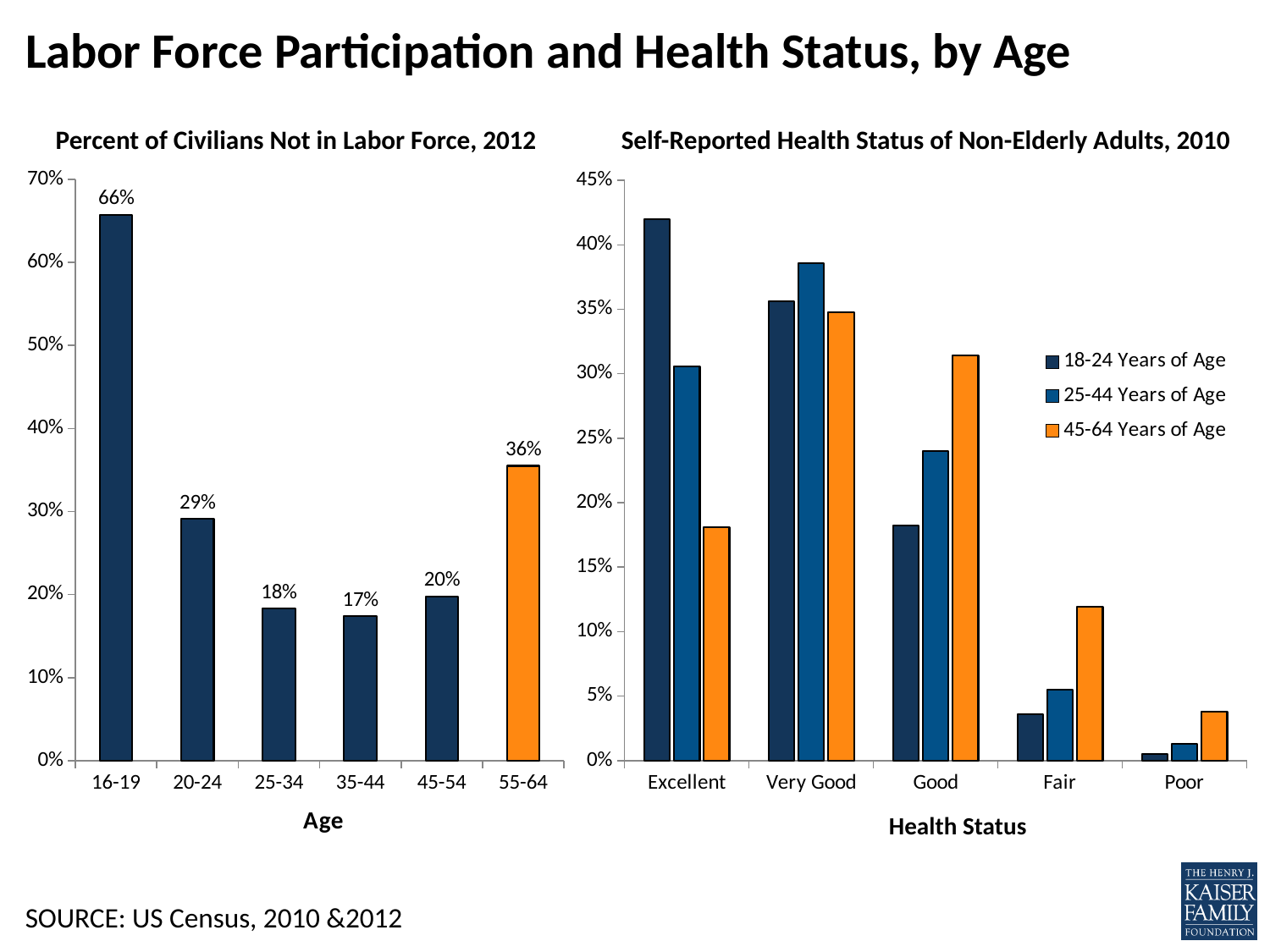
In the 'Self-Reported Health Status of Non-Elderly Adults, 2010' chart, which is larger for 45-64 Years of Age: Excellent or Very Good? Very Good In the 'Percent of Civilians Not in Labor Force, 2012' chart, what is the value for the 55-64 age group? 36% What type of chart is the 'Self-Reported Health Status of Non-Elderly Adults, 2010' chart? Bar chart In the 'Self-Reported Health Status of Non-Elderly Adults, 2010' chart, how many series does the legend list? 3 In the 'Self-Reported Health Status of Non-Elderly Adults, 2010' chart, is the value for 45-64 Years of Age in the Fair category greater or less than 10%? greater In the 'Percent of Civilians Not in Labor Force, 2012' chart, which age group has the highest value? 16-19 In the 'Percent of Civilians Not in Labor Force, 2012' chart, which age group has the lowest value? 35-44 In the 'Self-Reported Health Status of Non-Elderly Adults, 2010' chart, which age group has the highest value in the Good category? 45-64 Years of Age In the 'Self-Reported Health Status of Non-Elderly Adults, 2010' chart, is the value for 18-24 Years of Age in the Excellent category greater or less than 40%? greater In the 'Percent of Civilians Not in Labor Force, 2012' chart, what is the difference between the values for 16-19 and 20-24? 37% In the 'Percent of Civilians Not in Labor Force, 2012' chart, what is the value for the 16-19 age group? 66% In the 'Percent of Civilians Not in Labor Force, 2012' chart, how many age groups are shown? 6